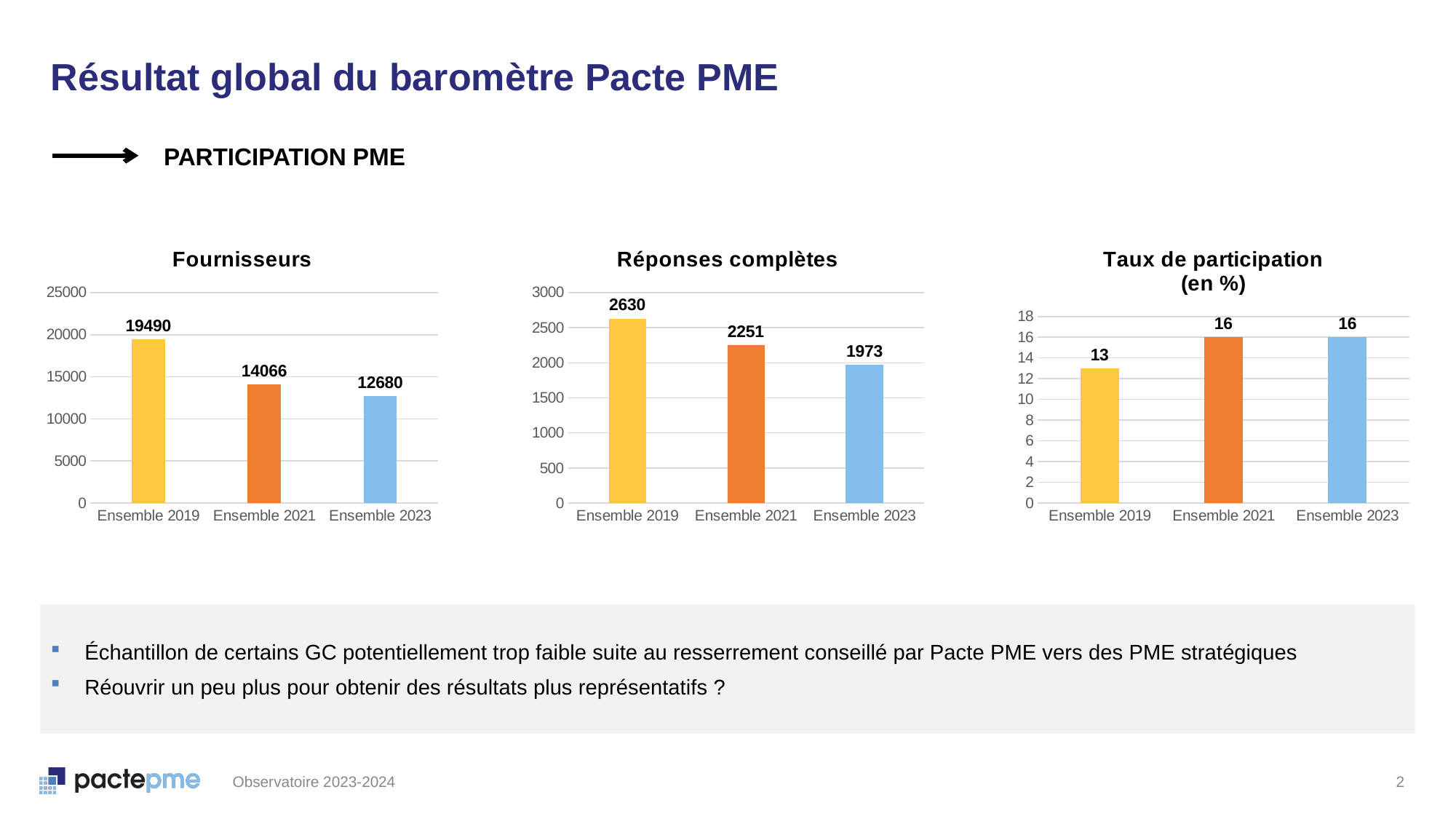
In the 'Taux de participation (en %)' chart, which is larger, Ensemble 2019 or Ensemble 2021? Ensemble 2021 In the 'Réponses complètes' chart, do the values rise or fall from Ensemble 2019 to Ensemble 2023? fall What kind of chart is the 'Réponses complètes' chart? bar chart In the 'Fournisseurs' chart, is the value for Ensemble 2021 greater or less than 15000? less In the 'Réponses complètes' chart, which category has the highest value? Ensemble 2019 How many categories are shown in the 'Fournisseurs' chart? 3 In the 'Fournisseurs' chart, which category has the lowest value? Ensemble 2023 In the 'Taux de participation (en %)' chart, what is the difference between Ensemble 2021 and Ensemble 2019? 3 In the 'Fournisseurs' chart, what is the difference between Ensemble 2019 and Ensemble 2021? 5424 In the 'Fournisseurs' chart, what is the value for Ensemble 2019? 19490 In the 'Réponses complètes' chart, what is the value for Ensemble 2023? 1973 In the 'Taux de participation (en %)' chart, what is the value for Ensemble 2019? 13